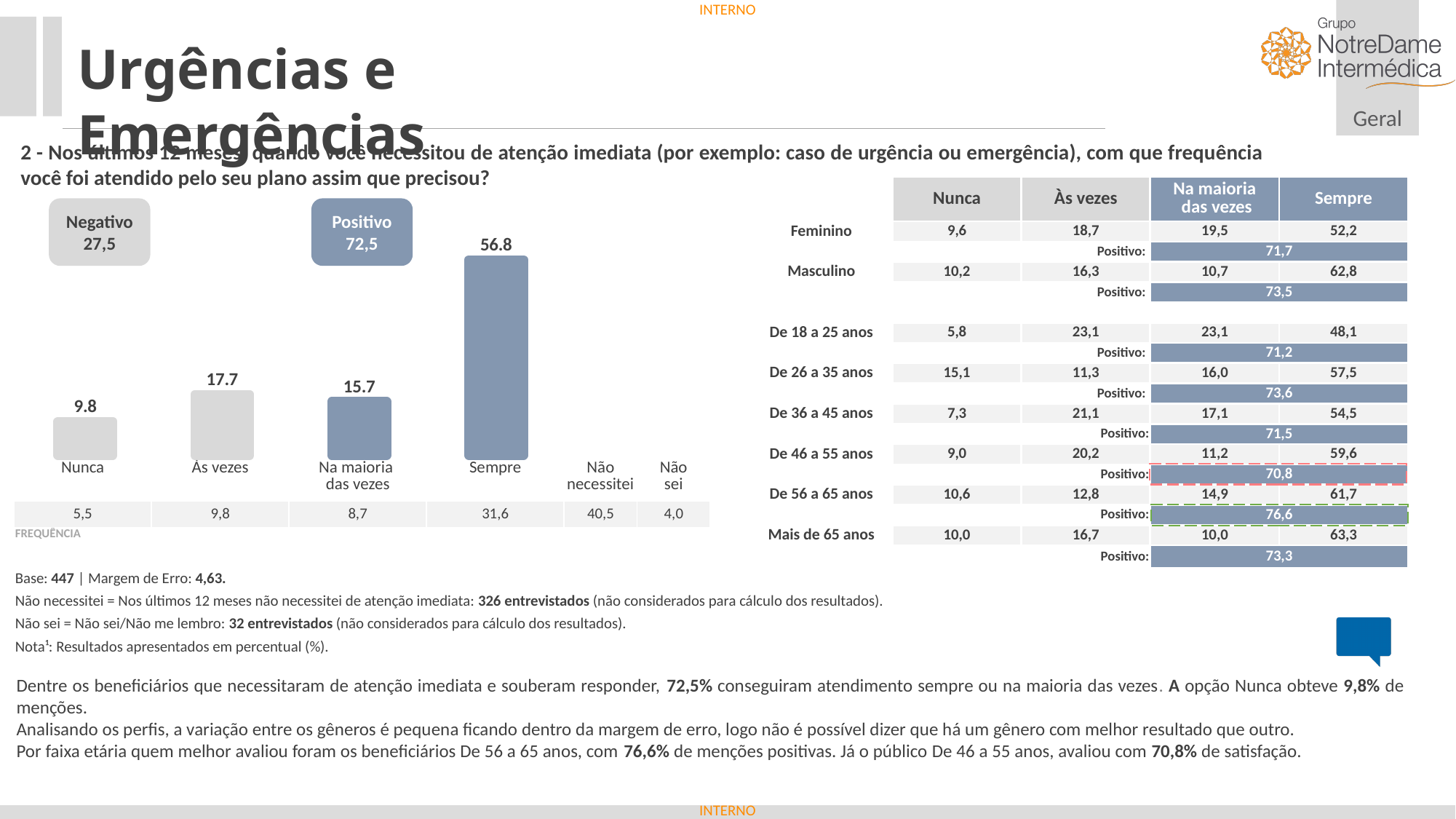
Which bar is larger in the bar chart, Às vezes or Na maioria das vezes? Às vezes What is the difference between the bars for Sempre and Nunca in the bar chart? 47.0 Which category has the lowest bar in the bar chart? Nunca What value is shown in the Positivo box above the bar chart? 72,5 Which category has the highest bar in the bar chart? Sempre What is the difference between the bars for Às vezes and Na maioria das vezes in the bar chart? 2.0 What is the value of the bar for Nunca in the bar chart? 9.8 What is the value of the bar for Às vezes in the bar chart? 17.7 How many bars are plotted in the bar chart? 4 What is the value of the bar for Na maioria das vezes in the bar chart? 15.7 What is the value of the bar for Sempre in the bar chart? 56.8 What type of chart is shown on the left of the slide? Bar chart